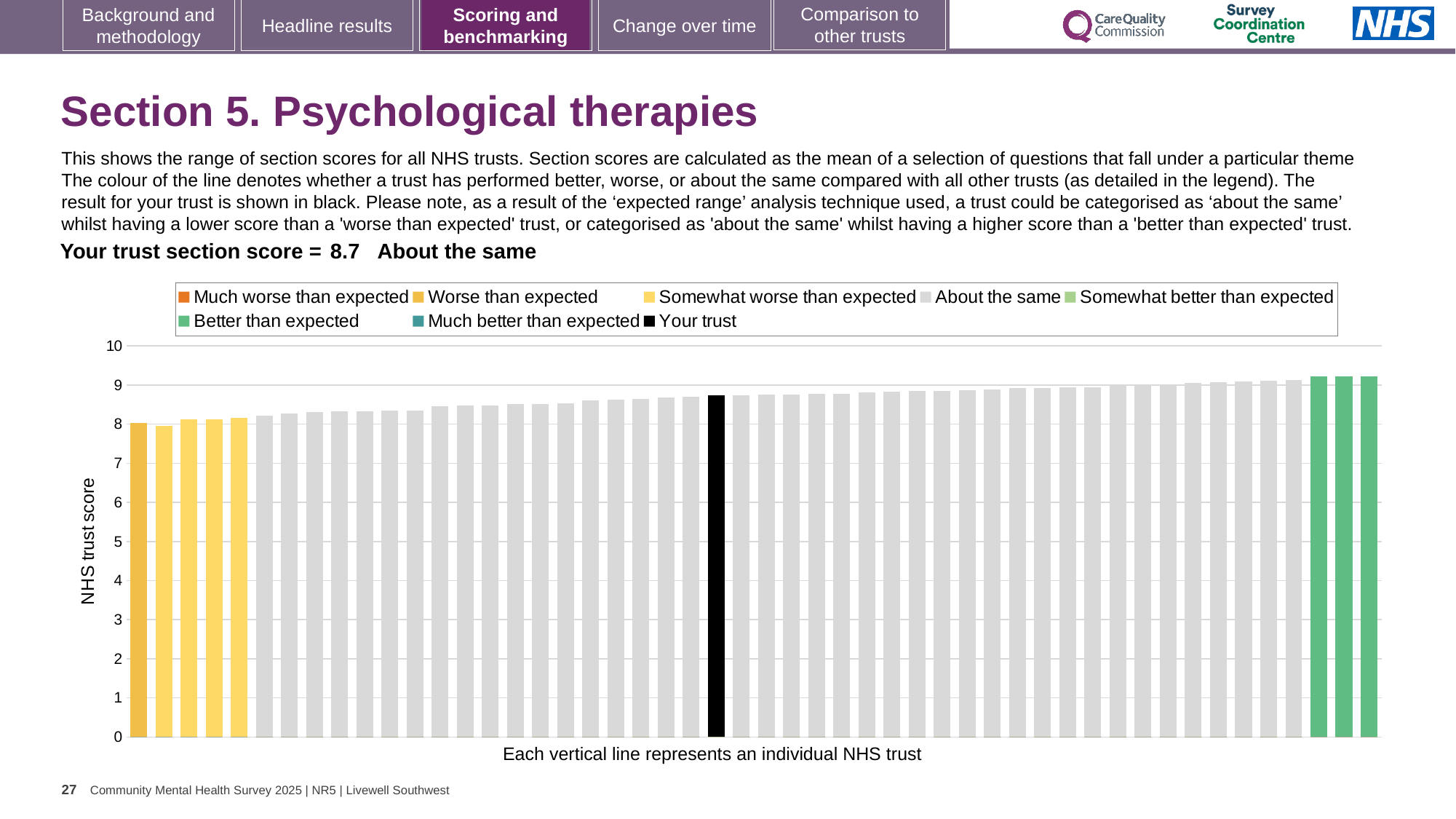
What is the title of the vertical axis? NHS trust score Which performance category is your trust's section score placed in? About the same Is the value for the rightmost bar greater or less than 10? less How many bars are coloured green (Better than expected) in the chart? 3 Is the value for the leftmost bar greater or less than 9? less Is the value for your trust (the black bar) greater or less than 8? greater What colour is the bar representing your trust? black How many entries does the chart legend list? 8 What is the section score for your trust shown on the slide? 8.7 Do the bar values rise or fall from left to right across the chart? rise What kind of chart is shown on the slide? bar chart